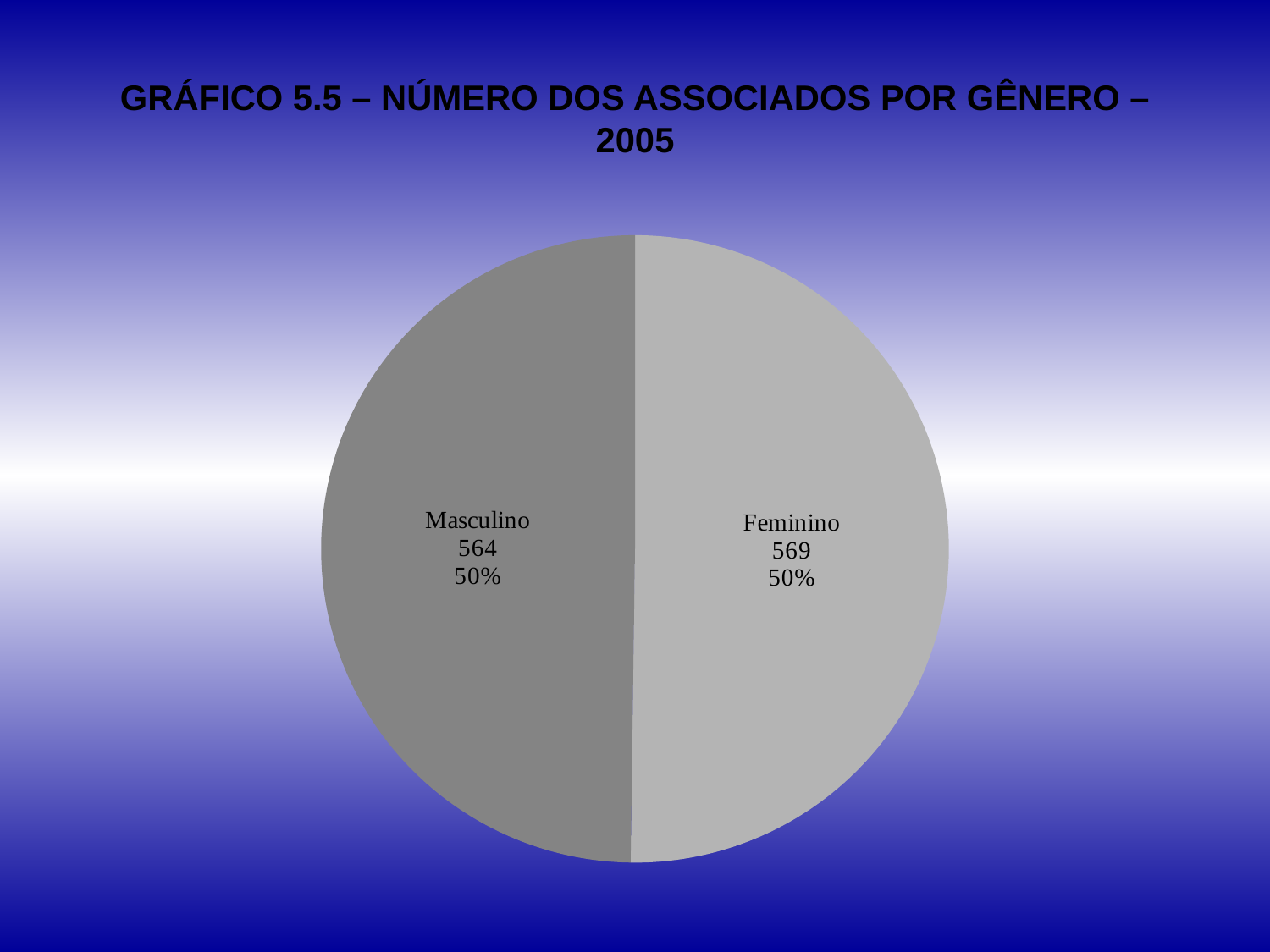
Which category has the higher count, Masculino or Feminino? Feminino What is the total number of associates shown in the chart? 1133 What is the title of the chart? GRÁFICO 5.5 – NÚMERO DOS ASSOCIADOS POR GÊNERO – 2005 What percentage share is shown for Feminino? 50% What is the difference between the Feminino and Masculino counts? 5 What percentage share is shown for Masculino? 50% What is the value for Feminino? 569 What kind of chart is shown on the slide? pie chart What is the value for Masculino? 564 Which slice is shown in the darker grey colour? Masculino How many slices does the pie chart have? 2